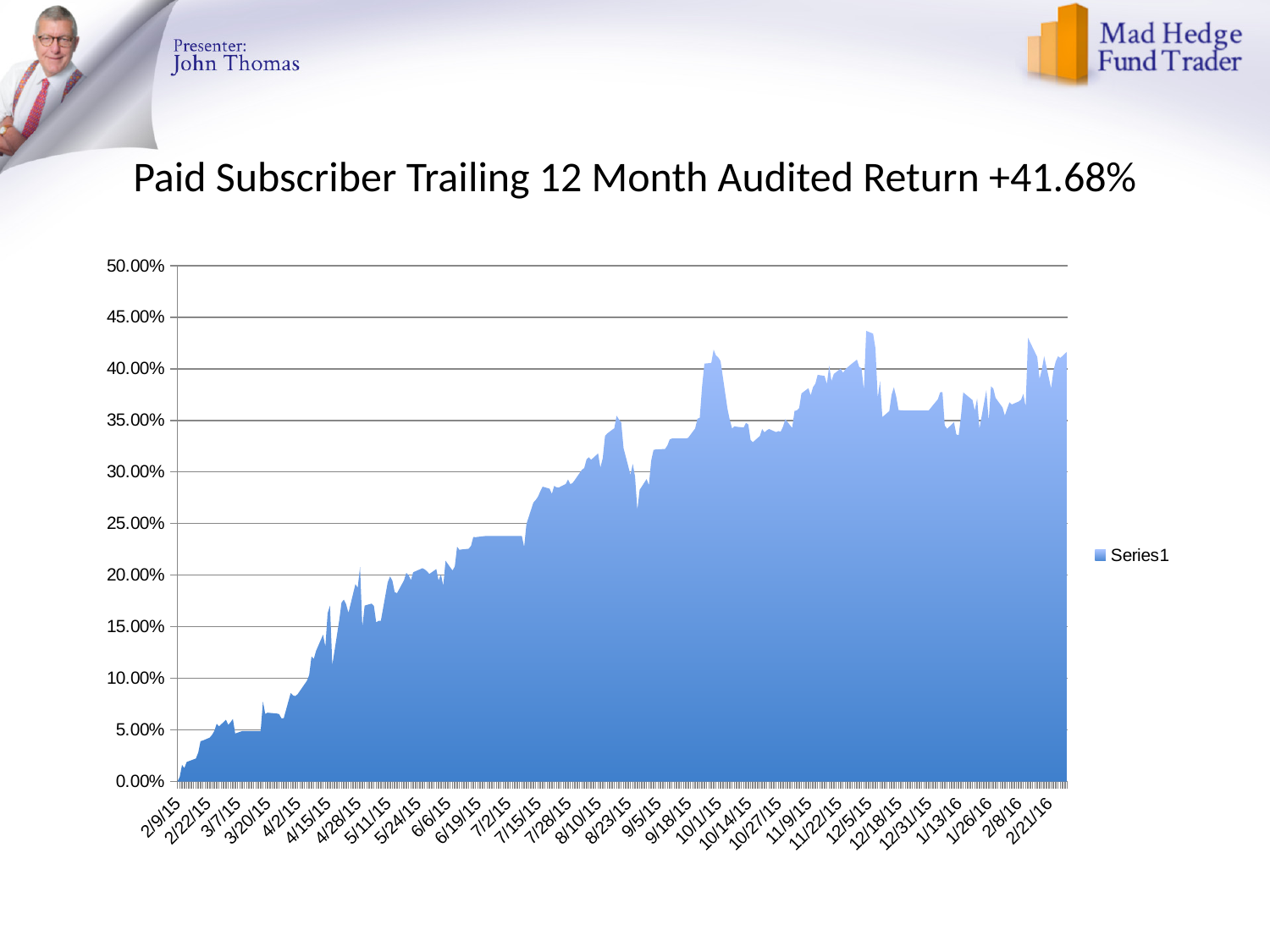
What is the name of the series shown in the legend? Series1 Is the value for 9/5/15 greater or less than 25.00%? greater Is the value for 7/2/15 greater or less than 20.00%? greater Is the value for 4/2/15 greater or less than 10.00%? less How many series does the legend list? 1 Which date has the lower value, 2/9/15 or 2/21/16? 2/9/15 What is the title of the chart on the slide? Paid Subscriber Trailing 12 Month Audited Return +41.68% Do the values generally rise or fall from 2/9/15 to 2/21/16? rise Which date has the larger value, 4/2/15 or 7/2/15? 7/2/15 What kind of chart is shown on the slide? area chart